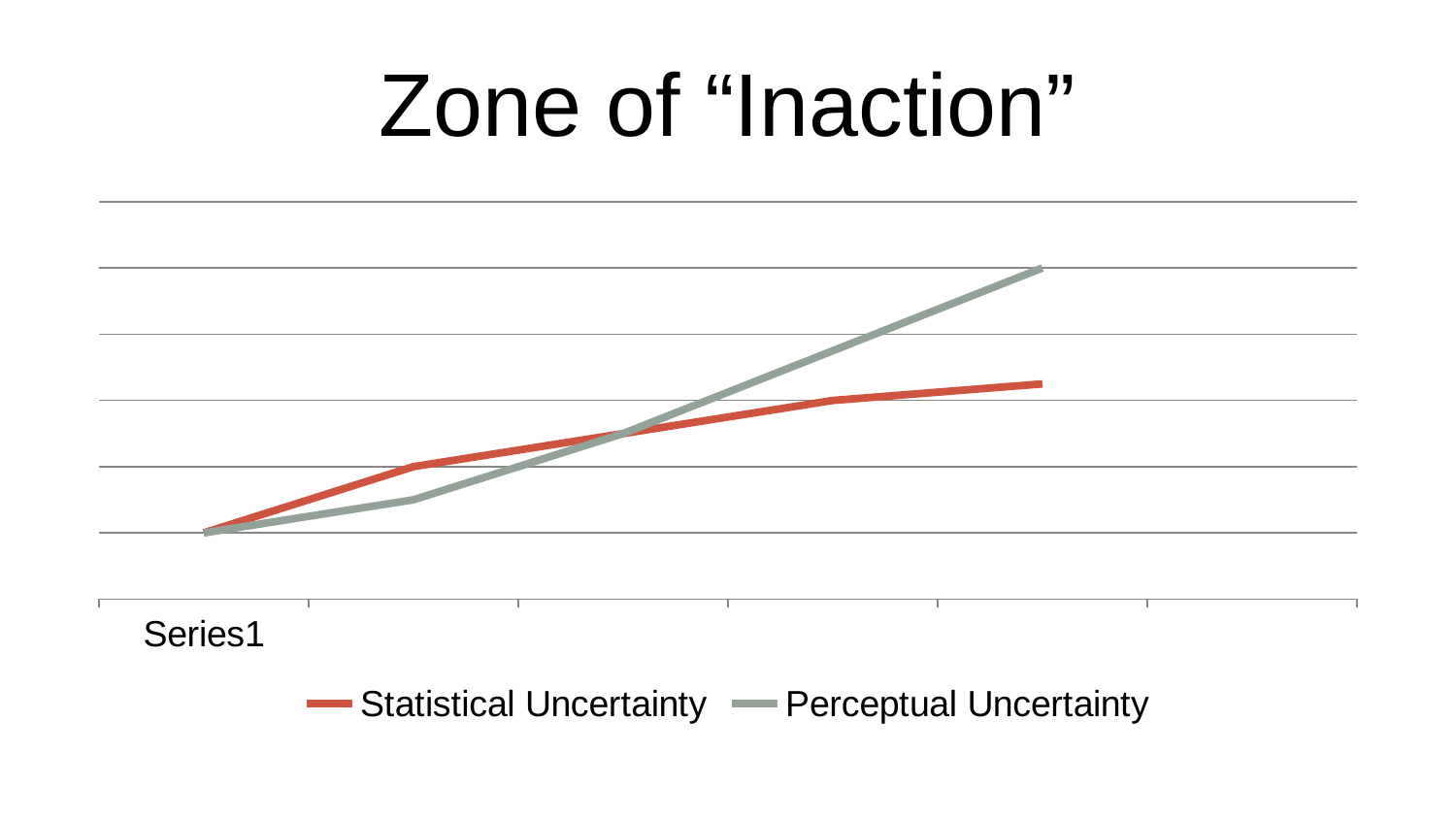
Which series are listed in the legend? Statistical Uncertainty and Perceptual Uncertainty How many series does the legend list? 2 What is the only category label shown on the x axis? Series1 At the second point from the left, which series has the higher value, Statistical Uncertainty or Perceptual Uncertainty? Statistical Uncertainty What is the title of the slide containing the chart? Zone of "Inaction" At the rightmost end of the chart, which series has the higher value, Statistical Uncertainty or Perceptual Uncertainty? Perceptual Uncertainty Which series reaches the highest point on the chart? Perceptual Uncertainty Does the Statistical Uncertainty line rise or fall from left to right? rise Does the Perceptual Uncertainty line rise or fall from left to right? rise What kind of chart is shown on the slide? line chart